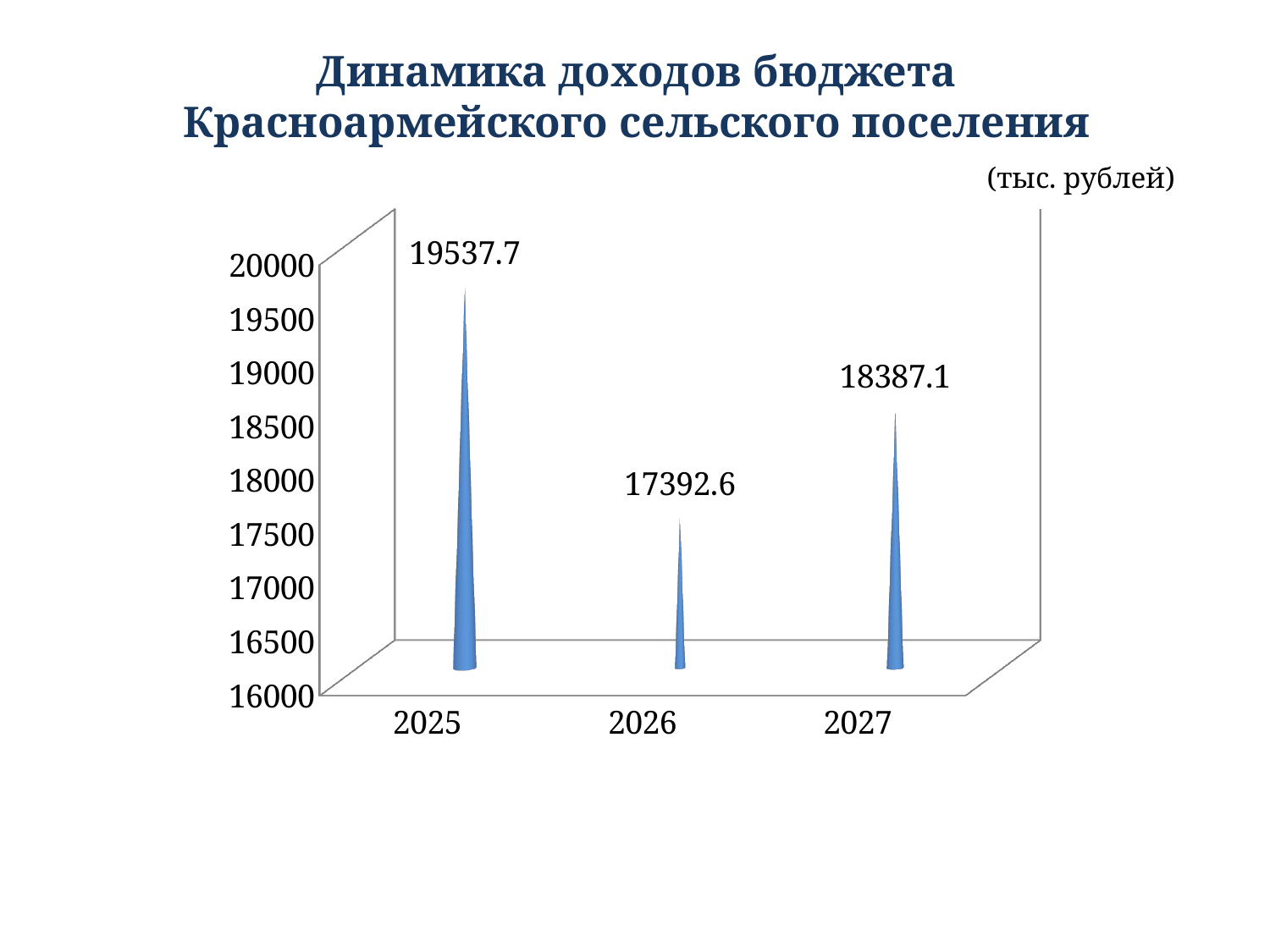
Which year has the lowest budget revenue? 2026 What kind of chart is shown on the slide? bar chart Which year has the highest budget revenue? 2025 What is the difference between the 2027 and 2026 values? 994.5 How many years are shown on the x axis? 3 What is the budget revenue value shown for 2026? 17392.6 What is the budget revenue value shown for 2027? 18387.1 What is the difference between the 2025 and 2026 values? 2145.1 What is the budget revenue value shown for 2025? 19537.7 In what units are the values on the chart expressed? тыс. рублей Which is larger, the value for 2027 or the value for 2026? 2027 Is the value for 2026 greater or less than 17500? less